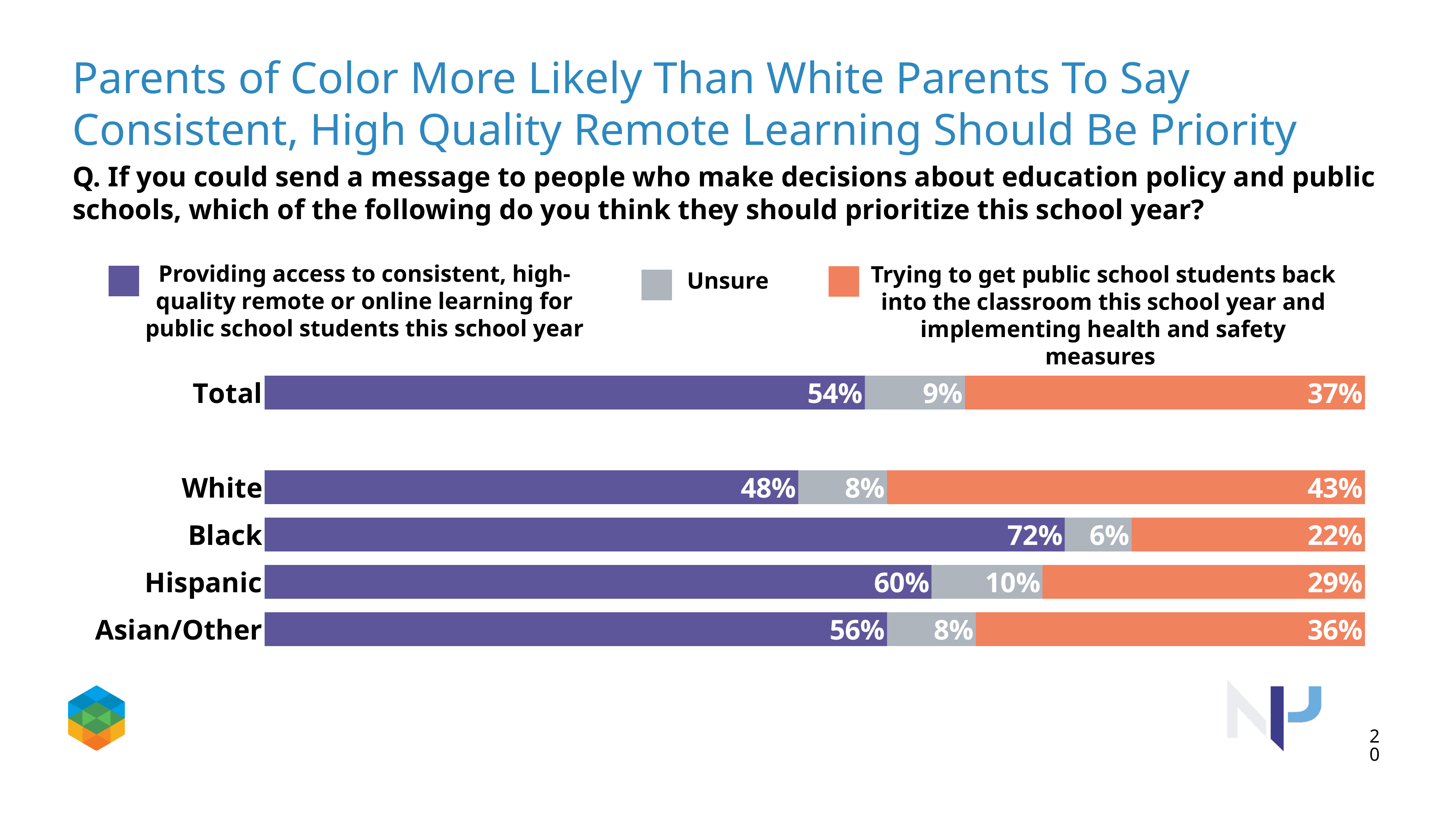
How many series does the legend list? 3 What is the difference between the percentage of Black parents and White parents who prioritize remote or online learning? 24 percentage points Which is larger: the percentage of Hispanic parents or Asian/Other parents who prioritize remote or online learning? Hispanic Which group has the lowest percentage saying students should get back into the classroom? Black What percentage of White parents say trying to get public school students back into the classroom should be the priority? 43% What percentage of Hispanic parents are unsure? 10% Which colour represents the 'Unsure' response in the chart? Gray What percentage of Black parents say providing access to consistent, high-quality remote or online learning should be the priority? 72% What kind of chart is shown on the slide? Stacked bar chart Which group has the highest percentage saying remote or online learning should be the priority? Black How many groups (bars) are shown in the chart? 5 What is the total of the three segments in the Total bar? 100%